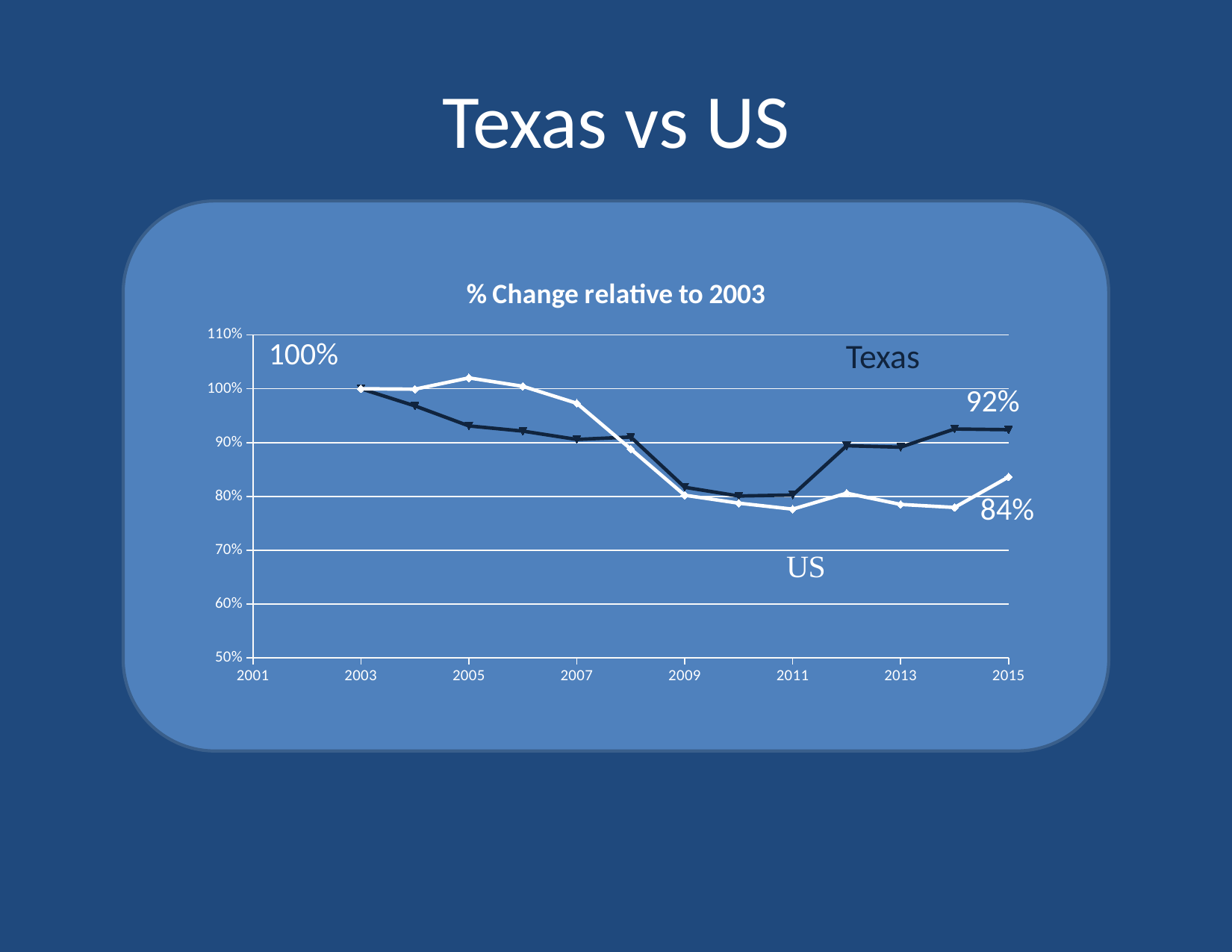
What is the title of the chart? % Change relative to 2003 What is the labelled value for Texas in 2015? 92% Is the value for US in 2011 greater or less than 80%? less How many series are plotted on the chart? 2 Which series is drawn with the white line? US What kind of chart is shown on the slide? line chart Is the value for Texas in 2007 greater or less than 100%? less Which series has the higher value in 2015, Texas or US? Texas Overall, do the values rise or fall from 2003 to 2015? fall What value do both series start at in 2003? 100% What is the labelled value for US in 2015? 84% What is the difference between the Texas and US values in 2015? 8 percentage points